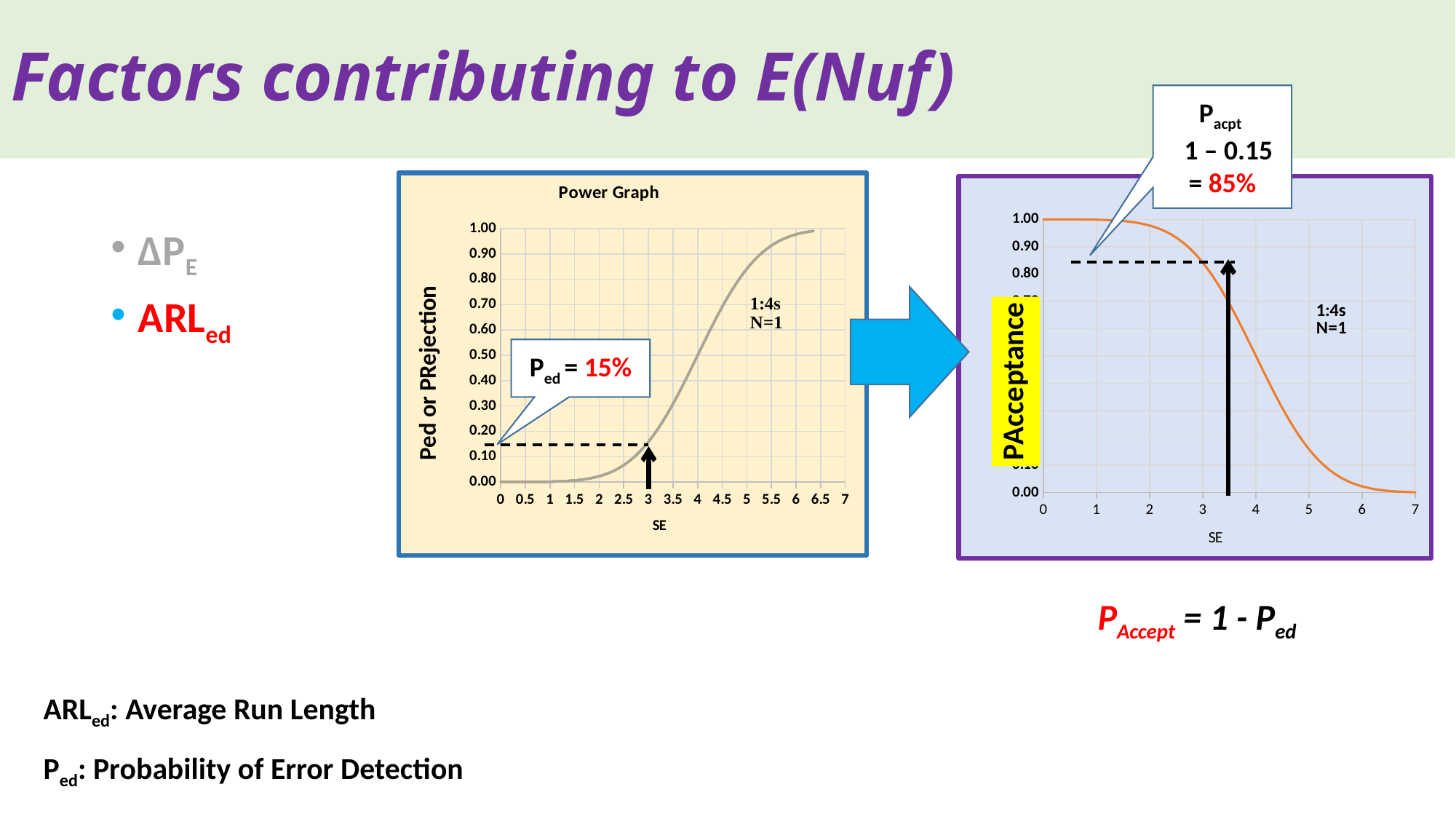
In the right PAcceptance chart, is the value at SE = 1 greater or less than 0.90? greater In the left "Power Graph" chart, is the value at SE = 5 greater or less than 0.80? greater In the left "Power Graph" chart, do the values rise or fall as SE increases? rise In the right PAcceptance chart, is the value at SE = 5 greater or less than 0.50? less What is the title of the left chart? Power Graph In the left "Power Graph" chart, what value of Ped is marked by the callout at SE = 3? 15% In the right PAcceptance chart, what value of Pacpt is marked by the callout? 85% In the right PAcceptance chart, do the values rise or fall as SE increases? fall What kind of chart is the left chart titled "Power Graph"? line chart What is the y-axis label of the left "Power Graph" chart? Ped or PRejection What kind of chart is the right chart with the PAcceptance axis? line chart